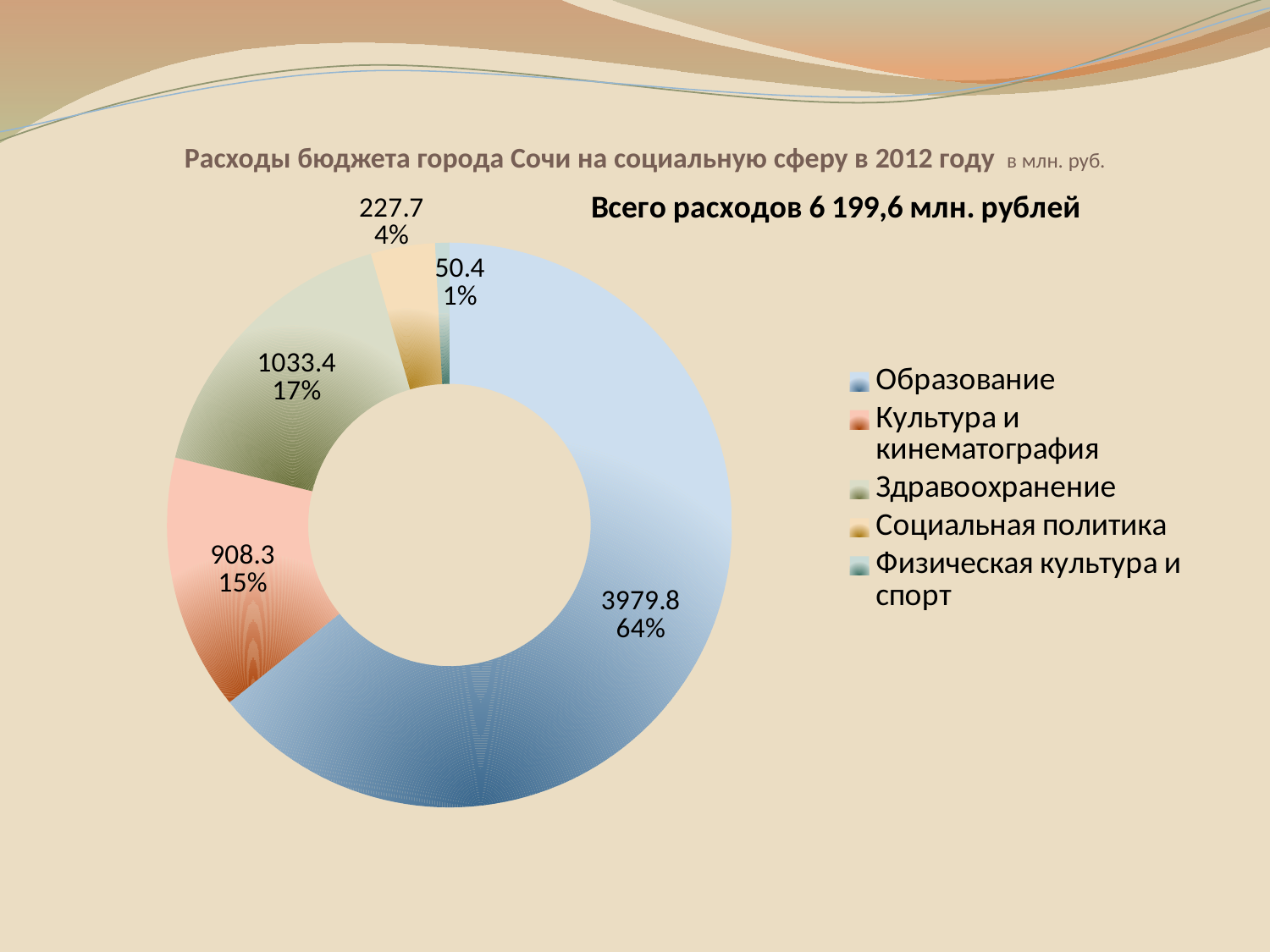
What is the value for Культура и кинематография? 908.3 What is the value for Образование? 3979.8 How many categories does the chart show? 5 Which category has the smallest value? Физическая культура и спорт What share of the chart does Физическая культура и спорт represent? 1% What is the value for Социальная политика? 227.7 What is the difference between the values for Здравоохранение and Культура и кинематография? 125.1 Which is larger, the value for Социальная политика or the value for Физическая культура и спорт? Социальная политика What kind of chart is shown on the slide? Doughnut chart What is the value for Здравоохранение? 1033.4 Which category has the largest value? Образование What share of the chart does Здравоохранение represent? 17%